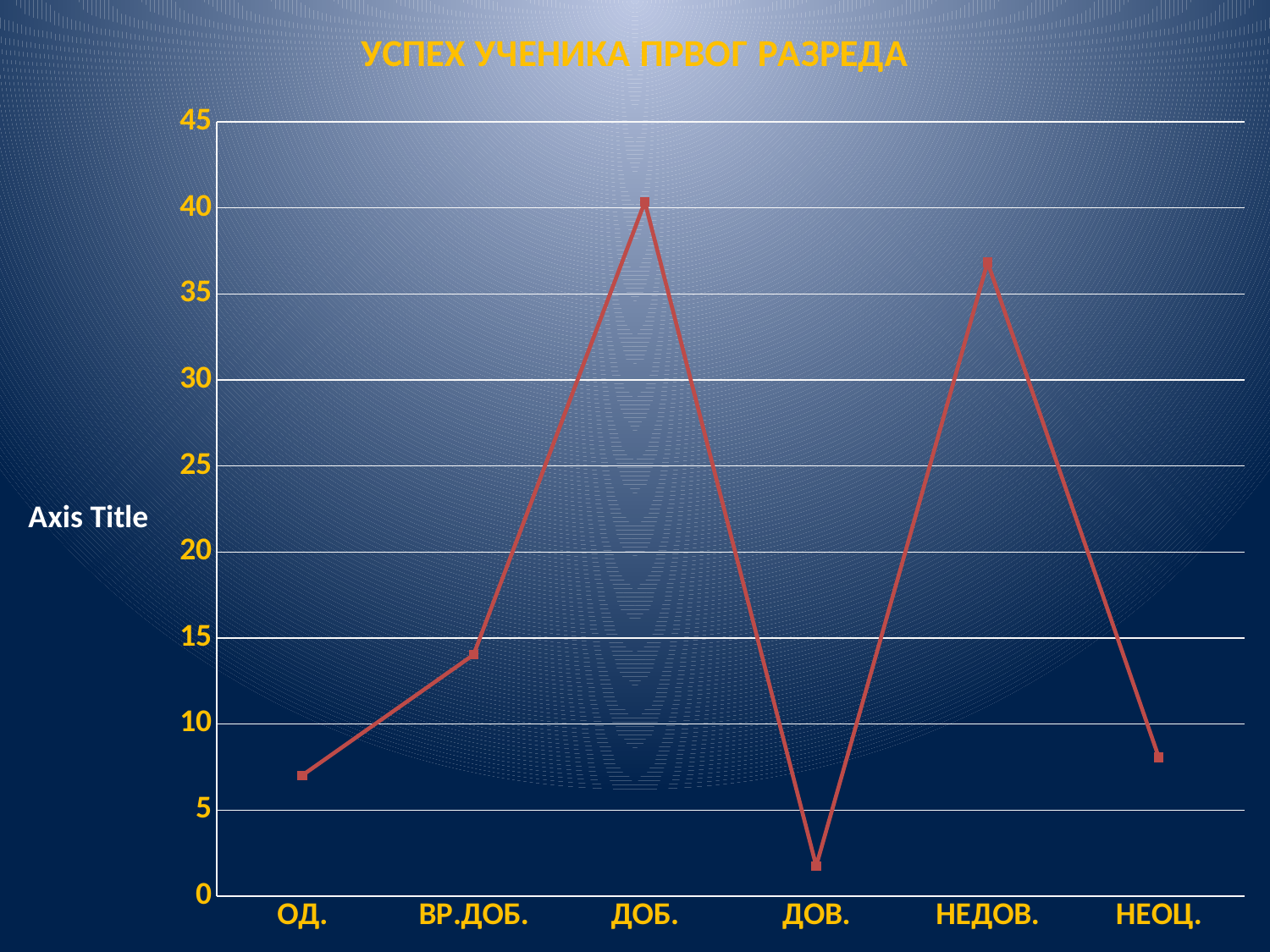
Which is larger, the value for ДОБ. or the value for НЕДОВ.? ДОБ. Which category has the highest value? ДОБ. Which category has the lowest value? ДОВ. Is the value for НЕДОВ. greater or less than 30? greater Do the values rise or fall from ОД. to ДОБ.? rise How many categories are plotted along the x axis? 6 Which is larger, the value for ВР.ДОБ. or the value for НЕОЦ.? ВР.ДОБ. Is the value for ДОВ. greater or less than 5? less Is the value for ДОБ. greater or less than 35? greater What is the title of the chart? УСПЕХ УЧЕНИКА ПРВОГ РАЗРЕДА What kind of chart is shown on the slide? line chart